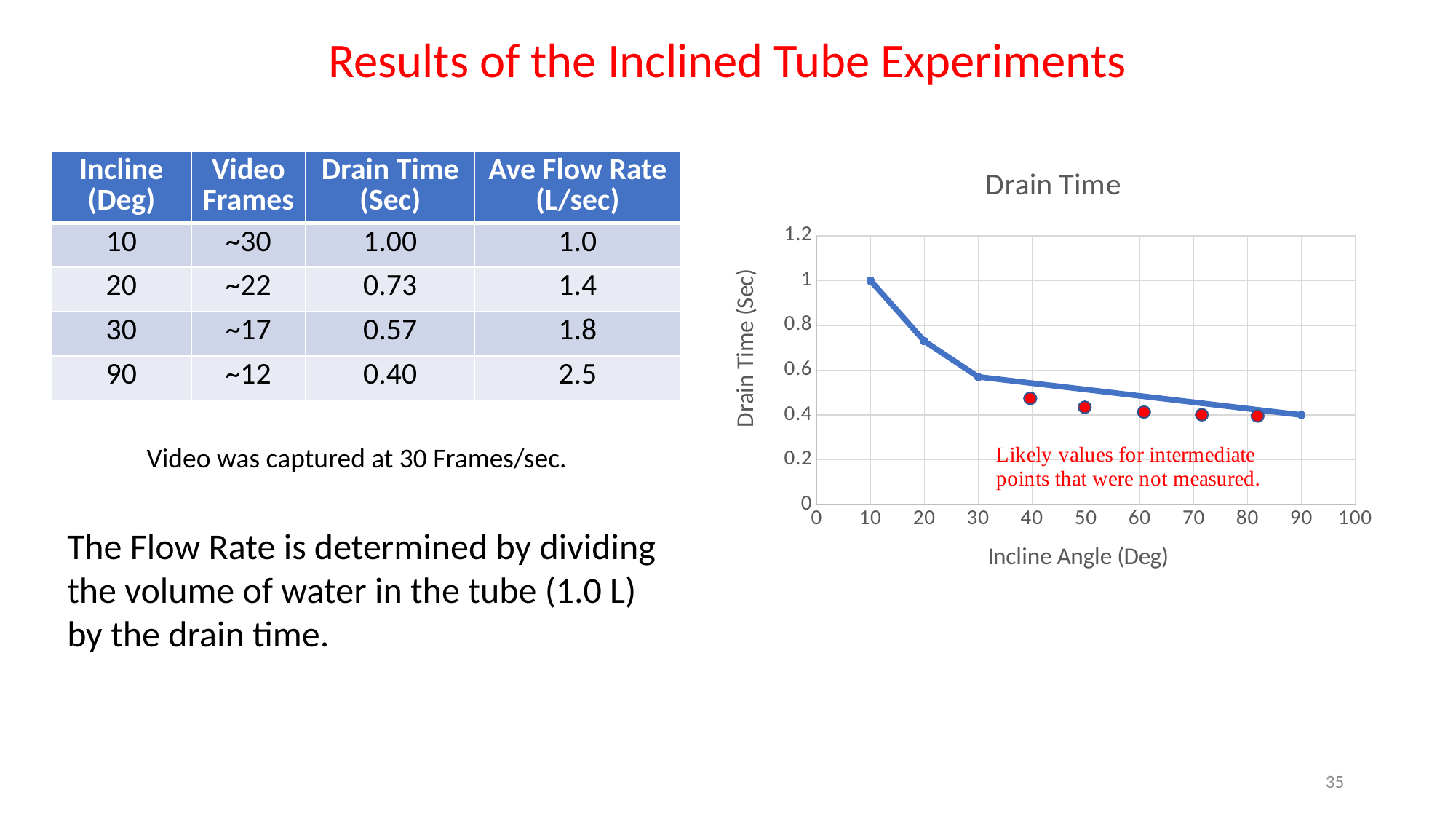
How many red dots marking likely intermediate values are shown on the chart? 5 What is the label of the x axis of the chart? Incline Angle (Deg) Which has the larger drain time, 20 degrees or 90 degrees? 20 degrees What kind of chart is shown on the slide? line chart What is the difference in drain time between 10 degrees and 90 degrees, using the values in the table? 0.60 Is the drain time at 20 degrees greater or less than 0.6 seconds? greater Is the drain time at 30 degrees greater or less than 0.4 seconds? greater At which incline angle is the drain time highest? 10 Does the drain time rise or fall as the incline angle increases? fall At which incline angle is the drain time lowest? 90 How many measured data points are plotted on the blue line? 4 What is the title of the chart? Drain Time